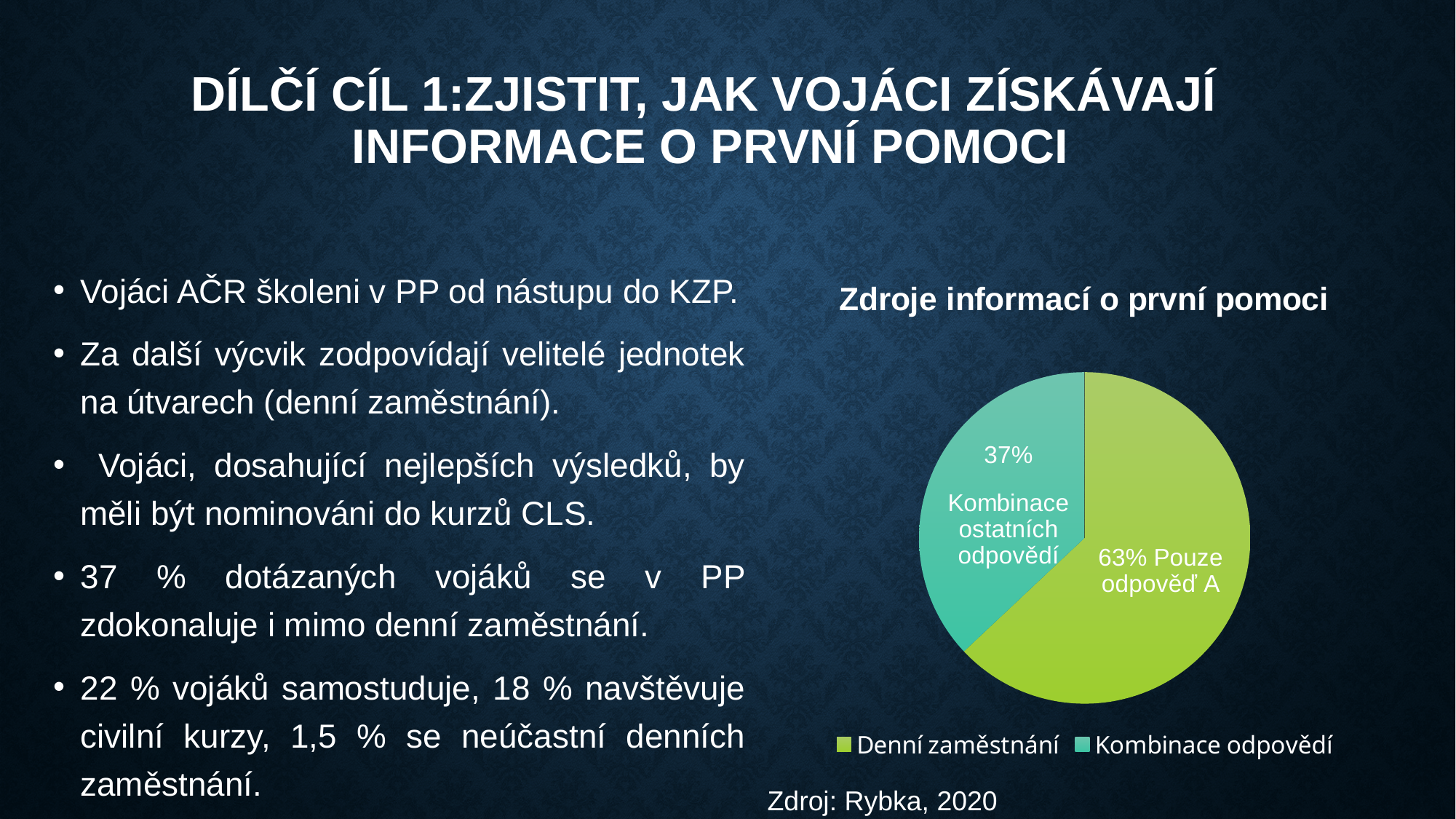
What is the difference in percentage points between the 'Denní zaměstnání' slice and the 'Kombinace odpovědí' slice? 26 Which is larger: the 'Denní zaměstnání' slice or the 'Kombinace odpovědí' slice? Denní zaměstnání How many entries does the legend list? 2 What kind of chart is shown on the slide? pie chart Which slice of the pie is the smallest? Kombinace odpovědí What percentage does the 'Denní zaměstnání' slice show? 63% What is the title of the chart? Zdroje informací o první pomoci Which slice of the pie is the largest? Denní zaměstnání What label is printed inside the 63% slice? 63% Pouze odpověď A What percentage does the 'Kombinace odpovědí' slice show? 37% How many slices does the pie chart have? 2 What share of the pie does the 'Kombinace odpovědí' slice represent? 37%